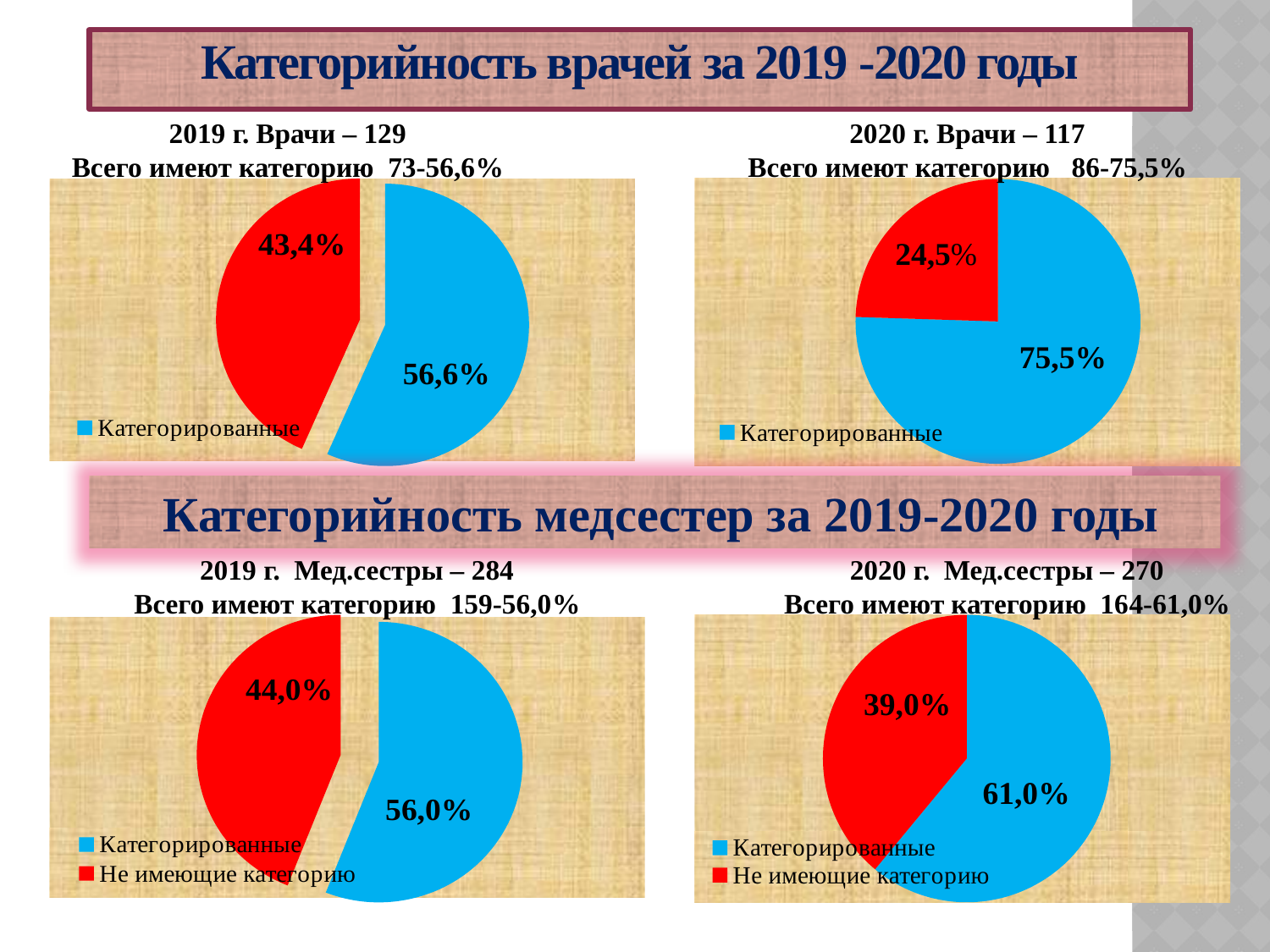
In the bottom-right pie chart (2020 nurses), what percentage is shown for 'Категорированные'? 61,0% In the bottom-left pie chart (2019 nurses), what percentage is shown for 'Не имеющие категорию'? 44,0% How many slices does the bottom-left pie chart (2019 nurses) have? 2 How many entries does the legend of the bottom-right pie chart (2020 nurses) list? 2 In the bottom-right pie chart (2020 nurses), which slice is larger, the blue one or the red one? the blue one In the top-right pie chart (2020 doctors), what is the difference between the blue slice and the red slice? 51,0% In the top-right pie chart (2020 doctors), what percentage is shown on the blue slice? 75,5% In the top-right pie chart (2020 doctors), what percentage is shown on the red slice? 24,5% In the top-left pie chart (2019 doctors), what percentage is shown on the red slice? 43,4% In the top-left pie chart (2019 doctors), what share of the pie is labelled for the blue 'Категорированные' slice? 56,6% What kind of chart is used for the 2019 doctors (top-left) chart? pie chart What colour is the 'Не имеющие категорию' slice in the bottom-left pie chart (2019 nurses)? red